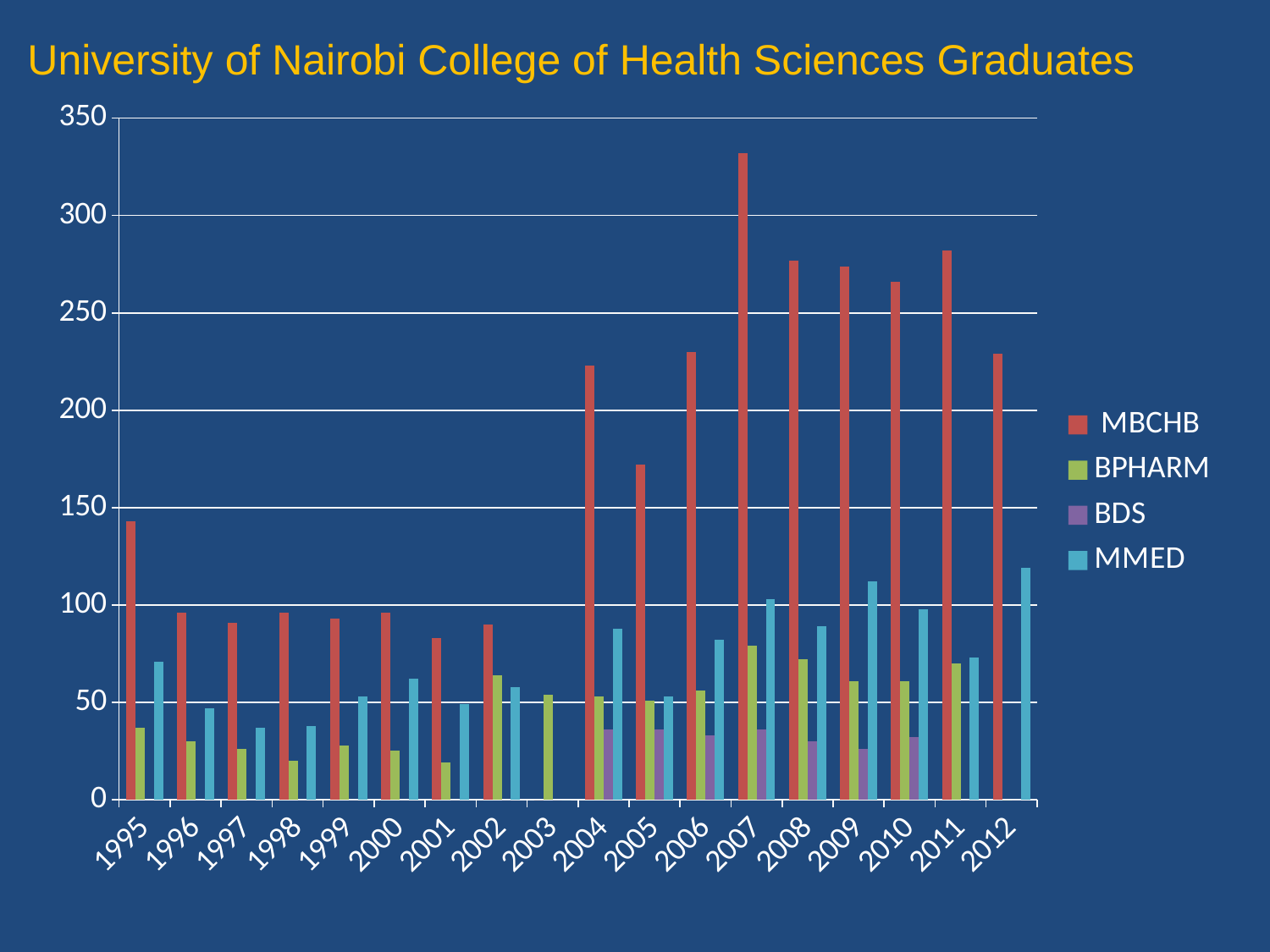
How many years are shown on the x axis? 18 Which is larger, the MBCHB value for 2004 or for 2005? 2004 Which is larger, the MMED value for 2009 or for 2011? 2009 In which year is the BPHARM value highest? 2007 What is the title of the chart? University of Nairobi College of Health Sciences Graduates Is the BPHARM value for 2002 greater or less than 50? greater Is the MBCHB value for 2007 greater or less than 300? greater How many series does the legend list? 4 What kind of chart is shown on the slide? Bar chart Is the MMED value for 2012 greater or less than 100? greater In which year is the MBCHB value highest? 2007